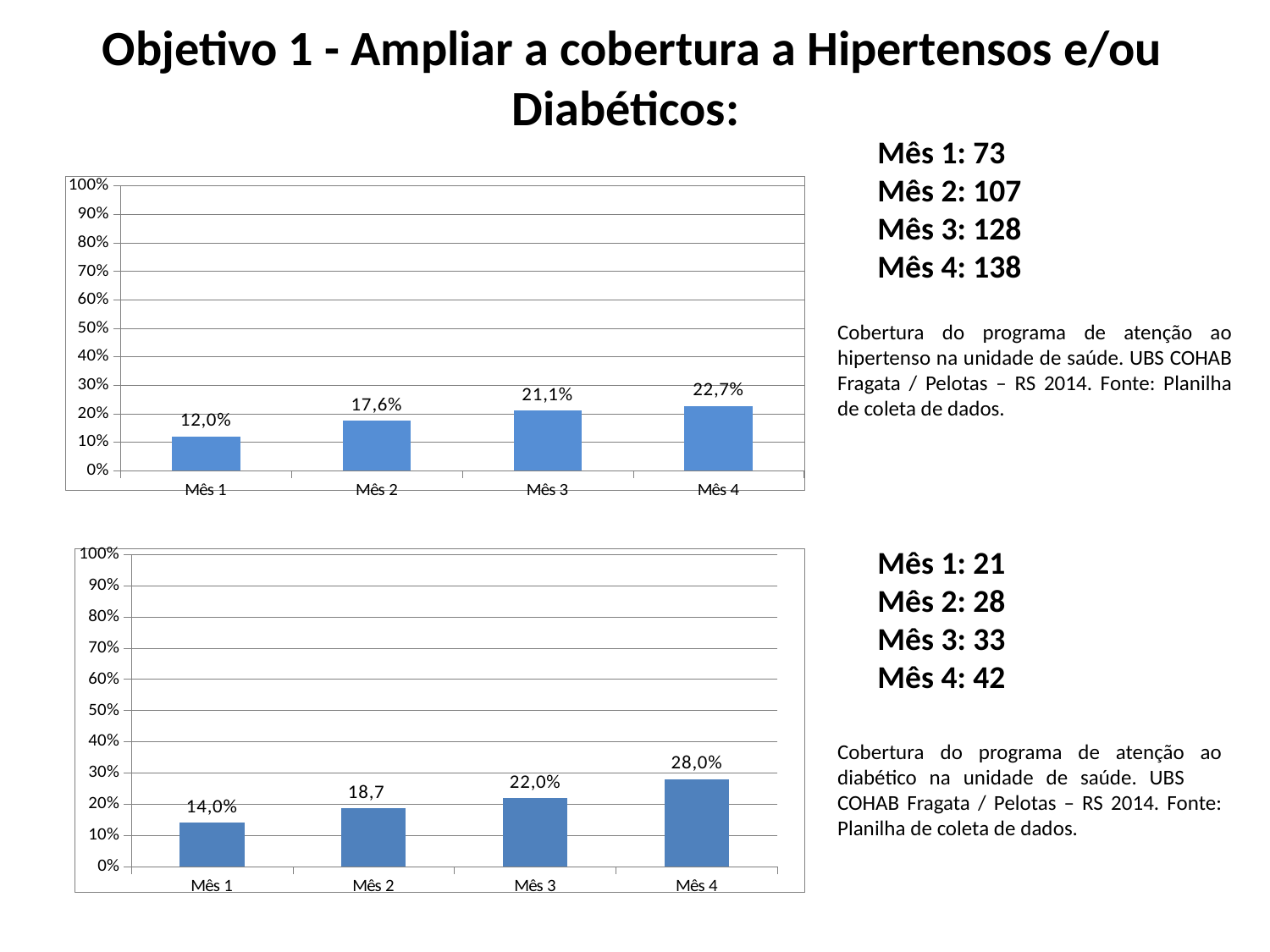
In the bottom chart, what is the value for Mês 4? 28,0% In the bottom chart, which is larger, the value for Mês 2 or the value for Mês 3? Mês 3 How many months are shown in the bottom chart? 4 In the bottom chart, what is the difference between the values for Mês 4 and Mês 3? 6,0% In the top chart, what is the difference between the values for Mês 4 and Mês 1? 10,7% In the top chart, what is the value for Mês 4? 22,7% In the top chart, what is the value for Mês 1? 12,0% In the top chart, is the value for Mês 3 greater or less than 30%? less In the bottom chart, which month has the lowest value? Mês 1 What kind of chart is the top chart? bar chart In the bottom chart, what is the value for Mês 3? 22,0% In the top chart, which month has the highest value? Mês 4